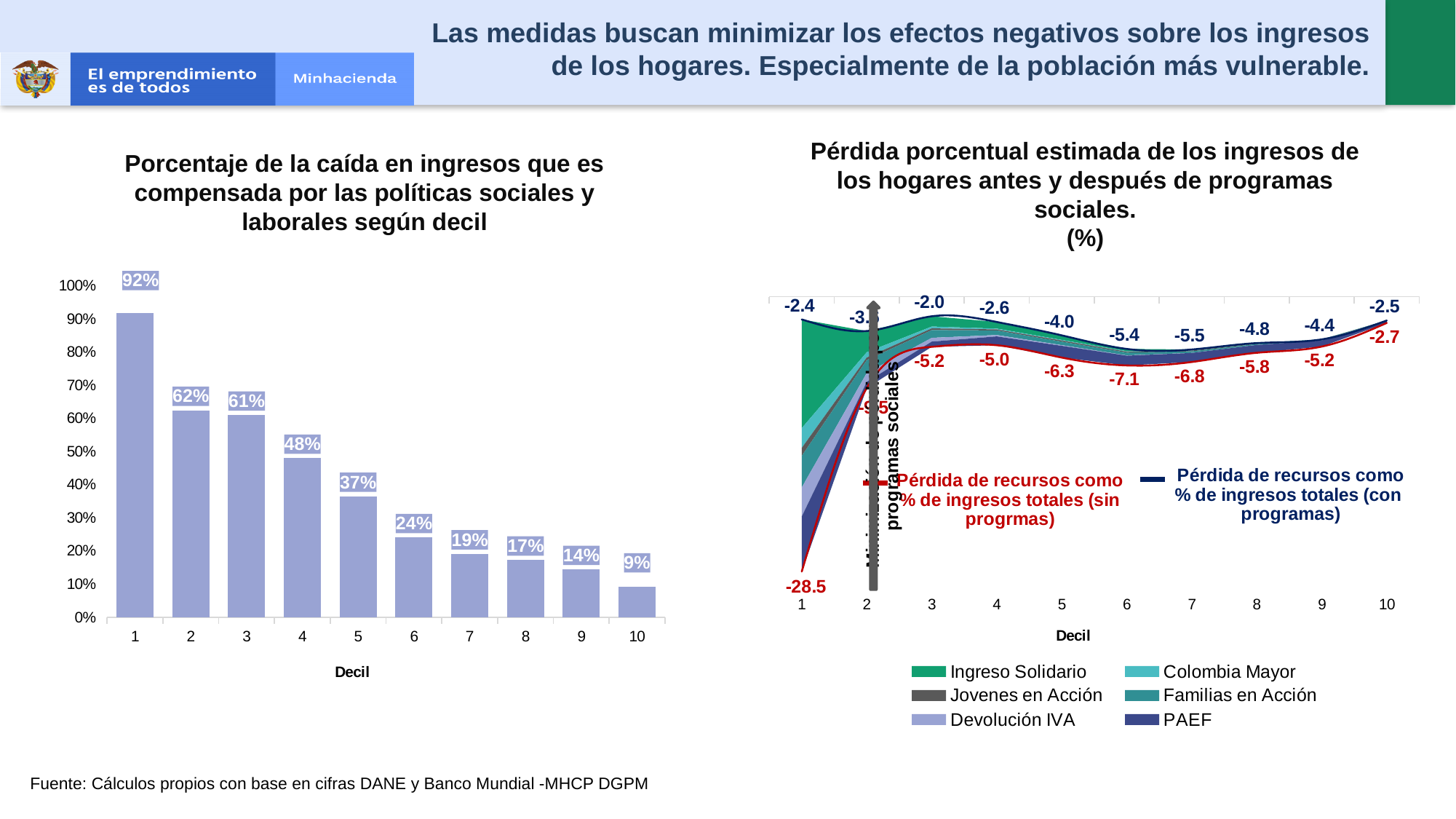
In the left chart, which decile has the lowest compensated percentage? 10 In the left chart, what is the value for decile 5? 37% In the right chart, how many series does the legend at the bottom list? 6 In the right chart, which decile has the largest loss without programs (most negative red value)? 1 In the left chart, do the values rise or fall as the decile increases from 1 to 10? fall In the right chart, what is the loss without programs for decile 10? -2.7 In the left chart, what is the difference between the values for decile 2 and decile 3? 1% In the left chart, how many deciles are plotted? 10 In the left chart, what percentage of the income drop is compensated for decile 1? 92% In the right chart, what is the loss of resources with programs (con programas) for decile 6? -5.4 What kind of chart is the left chart? bar chart In the right chart, what is the loss of resources without programs (sin programas) for decile 1? -28.5